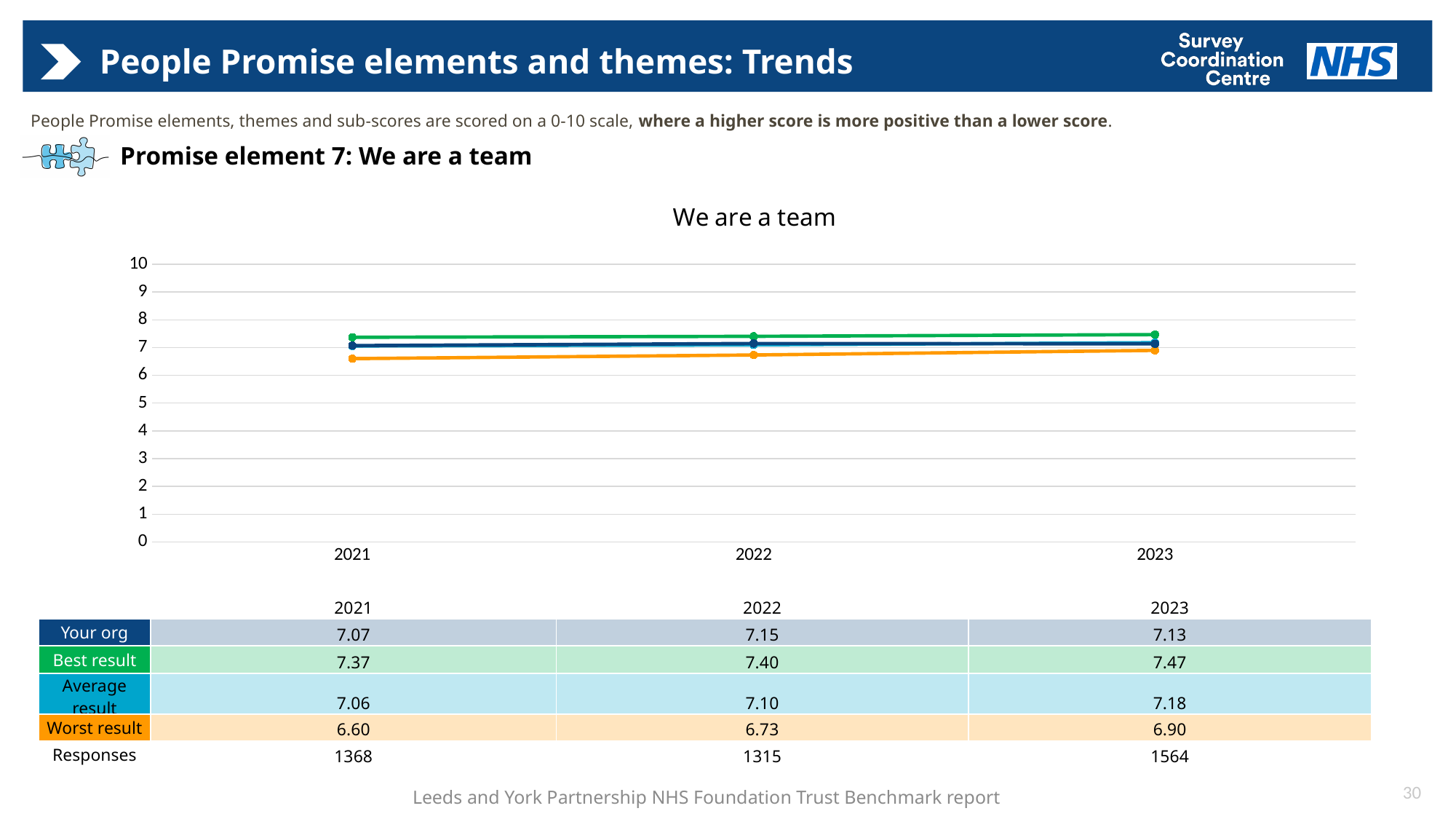
What is the Average result score for 2023? 7.18 In which year is the Worst result score lowest? 2021 What is the Worst result score for 2021? 6.60 What is the difference between the Best result and Worst result scores in 2023? 0.57 What is the Best result score for 2023? 7.47 What type of chart is shown on the slide? Line chart In which year is the Best result score highest? 2023 Does the Worst result score rise or fall from 2021 to 2023? Rise What is the Your org score for 2022? 7.15 Which is larger in 2023, the Your org score or the Average result score? Average result What is the title of the chart? We are a team How many years are shown on the x axis of the chart? 3